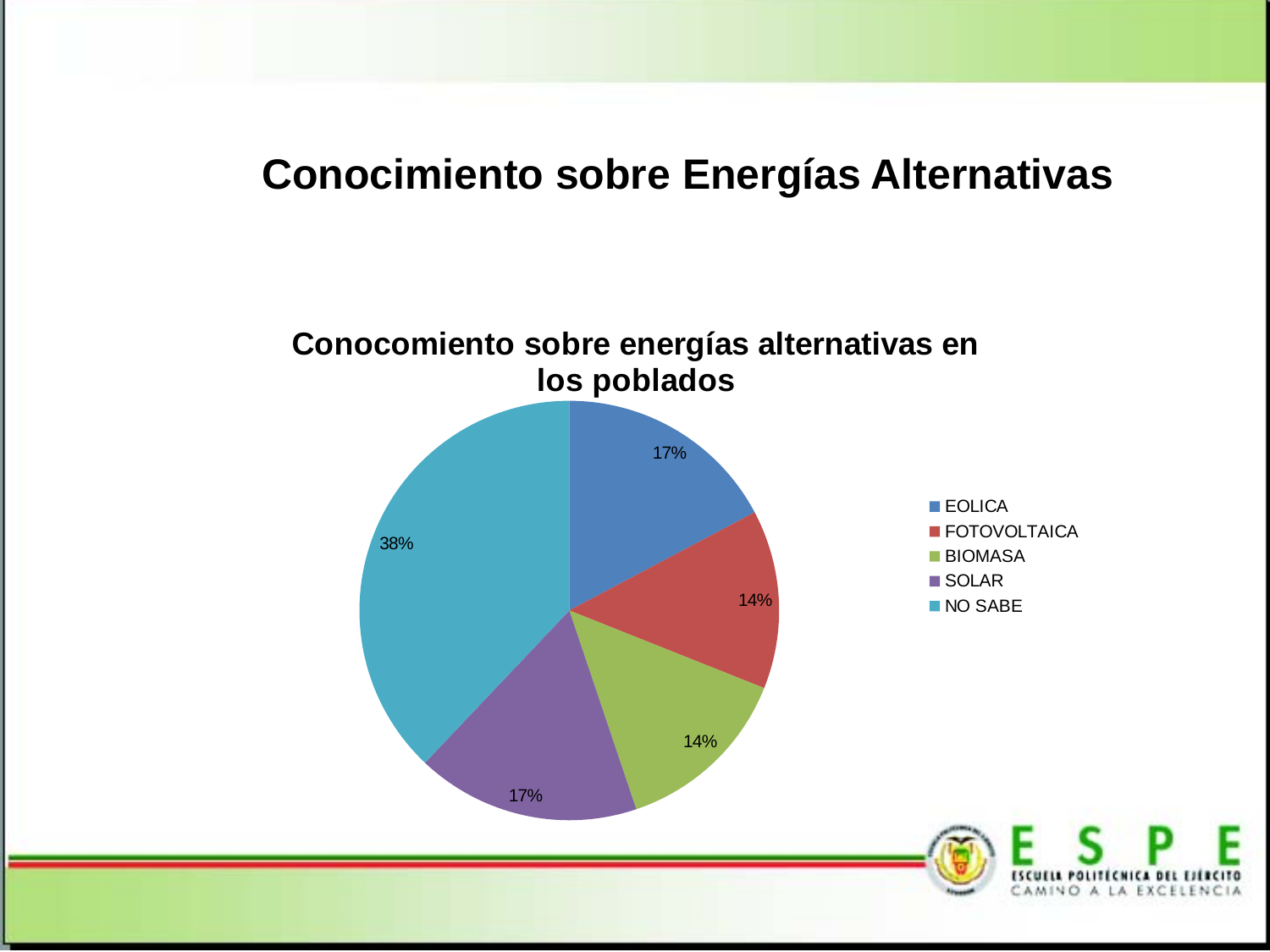
What is the difference in percentage points between NO SABE and SOLAR? 21 What is the title of the chart? Conocomiento sobre energías alternativas en los poblados What percentage of the pie is BIOMASA? 14% What percentage of the pie is SOLAR? 17% Which category has the largest slice of the pie? NO SABE What colour is the NO SABE slice? light blue What percentage of the pie is EOLICA? 17% Which is larger, the slice for NO SABE or the slice for BIOMASA? NO SABE What percentage of the pie is FOTOVOLTAICA? 14% What kind of chart is shown on the slide? pie chart What percentage of the pie is NO SABE? 38% How many categories does the legend list? 5